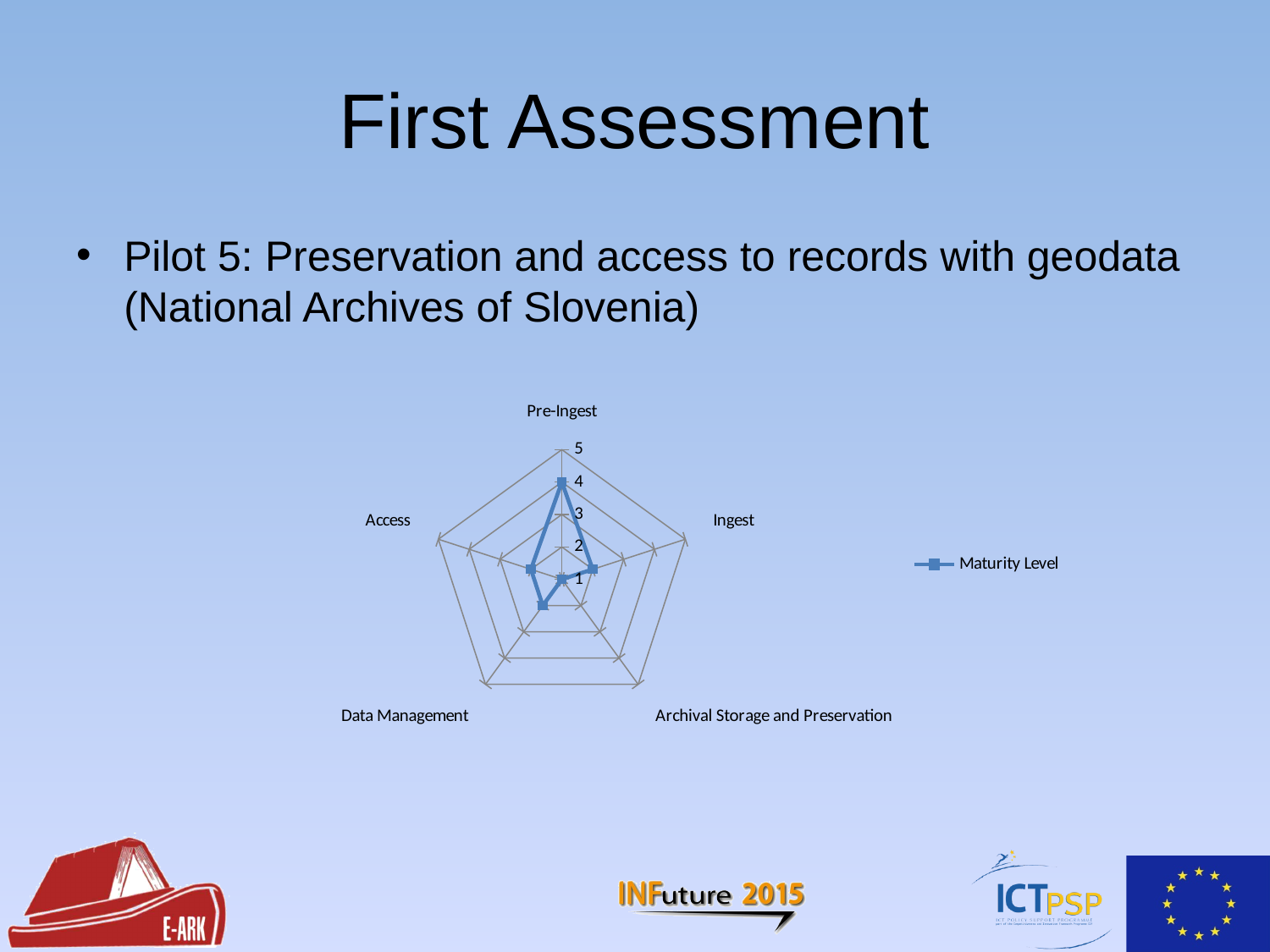
What is the name of the series shown in the chart legend? Maturity Level What is the maximum value shown on the chart's axis scale? 5 Is the Maturity Level for Access greater or less than 3? less What kind of chart is shown on the slide? Radar chart Which category has the lowest Maturity Level in the chart? Archival Storage and Preservation How many categories (axes) does the radar chart have? 5 How many series does the legend of the chart list? 1 Is the Maturity Level for Pre-Ingest greater or less than 3? greater Which category has the highest Maturity Level in the chart? Pre-Ingest What is the Maturity Level for Pre-Ingest? 4 Which has a higher Maturity Level, Pre-Ingest or Data Management? Pre-Ingest Is the Maturity Level for Ingest greater or less than 3? less